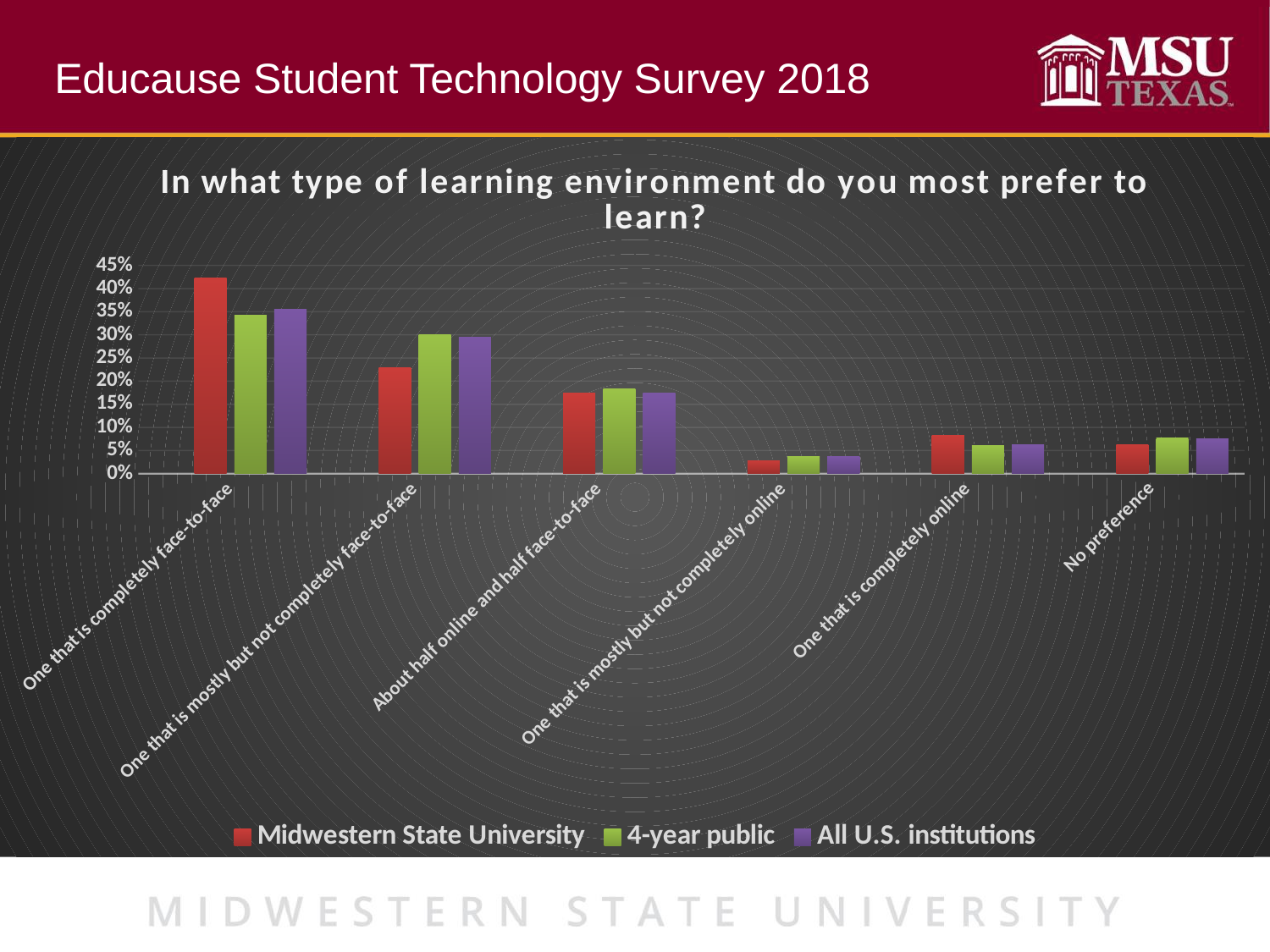
How many learning environment categories are shown on the x axis? 6 Is the 4-year public value for 'One that is mostly but not completely face-to-face' greater or less than 25%? greater Which learning environment has the lowest value for Midwestern State University? One that is mostly but not completely online Is the All U.S. institutions value for 'One that is mostly but not completely online' greater or less than 5%? less For 'One that is mostly but not completely face-to-face', which is larger: Midwestern State University or All U.S. institutions? All U.S. institutions What kind of chart is shown on the slide? bar chart Which learning environment has the highest value for Midwestern State University? One that is completely face-to-face For 'One that is completely face-to-face', which is larger: Midwestern State University or 4-year public? Midwestern State University What is the title of the chart? In what type of learning environment do you most prefer to learn? Is the Midwestern State University value for 'One that is completely face-to-face' greater or less than 40%? greater How many series does the legend list? 3 What colour represents Midwestern State University in the legend? red